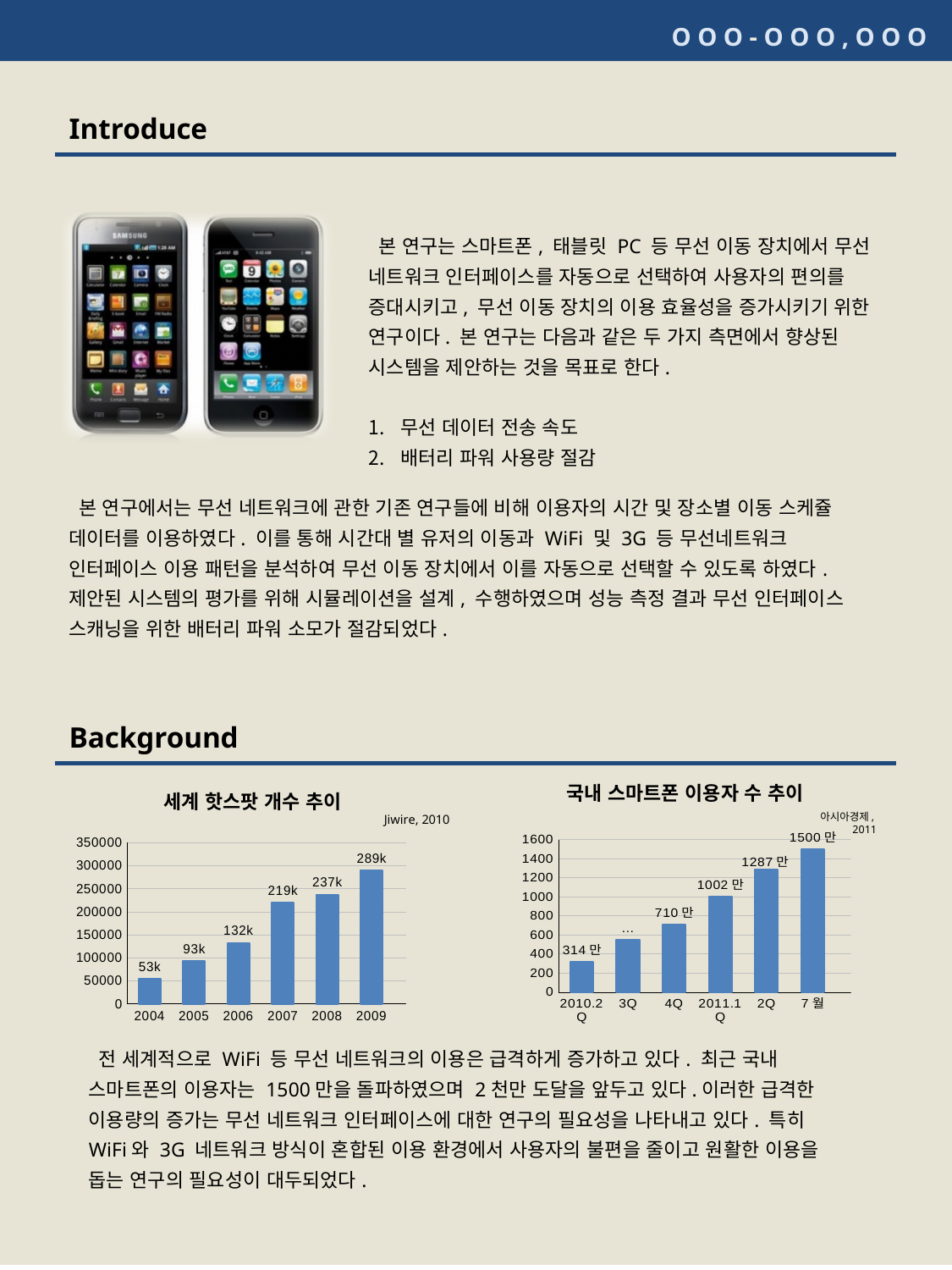
In the '세계 핫스팟 개수 추이' chart, how many years are shown on the x axis? 6 What kind of chart is '세계 핫스팟 개수 추이'? bar chart In the '세계 핫스팟 개수 추이' chart, what is the value for 2004? 53k In the '세계 핫스팟 개수 추이' chart, what is the difference between the values for 2009 and 2008? 52k In the '국내 스마트폰 이용자 수 추이' chart, is the value for 3Q greater or less than 400? greater In the '국내 스마트폰 이용자 수 추이' chart, what is the value for 7 월? 1500 만 In the '세계 핫스팟 개수 추이' chart, what is the value for 2007? 219k In the '국내 스마트폰 이용자 수 추이' chart, what is the difference between the values for 2Q and 2011.1Q? 285 만 In the '국내 스마트폰 이용자 수 추이' chart, what is the value for 2011.1Q? 1002 만 In the '세계 핫스팟 개수 추이' chart, which year has the highest value? 2009 In the '국내 스마트폰 이용자 수 추이' chart, which category has the lowest value? 2010.2Q In the '세계 핫스팟 개수 추이' chart, do the values rise or fall from 2004 to 2009? rise